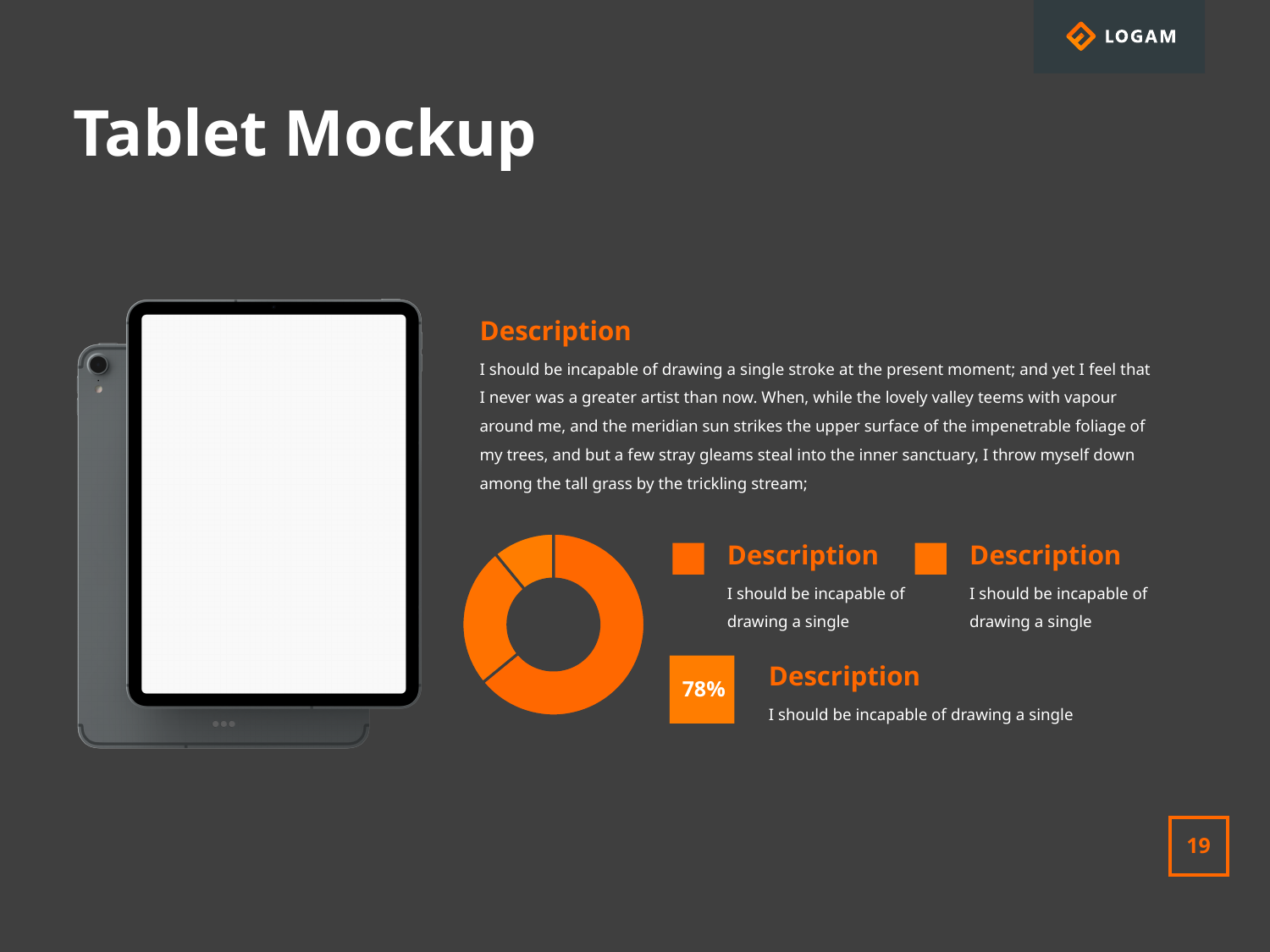
How many slices does the donut chart have? 3 What colour family is used for all slices of the donut chart? Orange Does the largest slice of the donut chart cover more or less than half of the ring? More What kind of chart is shown on the slide? Pie chart (donut) Does the donut chart have a legend? No Which colour slice is the largest in the donut chart? Dark orange